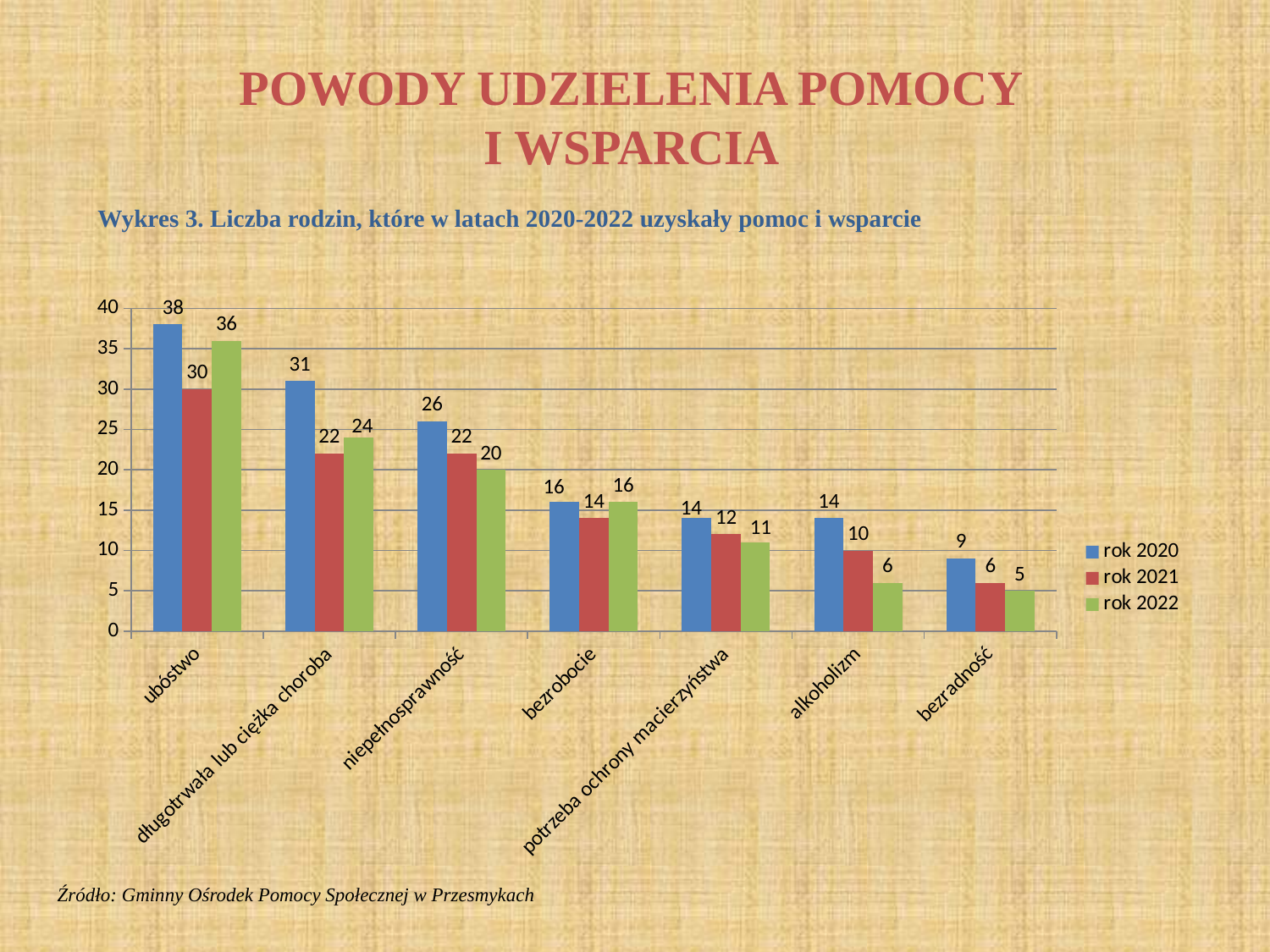
Which category has the highest value in rok 2021? ubóstwo What is the value for alkoholizm in rok 2022? 6 Is the value for potrzeba ochrony macierzyństwa in rok 2022 greater or less than 15? less What is the value for niepełnosprawność in rok 2021? 22 Which is larger for bezrobocie: the rok 2020 value or the rok 2021 value? rok 2020 How many series does the legend list? 3 What is the value for ubóstwo in rok 2020? 38 Which category has the lowest value in rok 2022? bezradność What is the difference between the rok 2020 and rok 2022 values for długotrwała lub ciężka choroba? 7 Do the rok 2020 values rise or fall from ubóstwo to bezradność? fall What kind of chart is shown on the slide? bar chart How many categories are shown on the x axis? 7